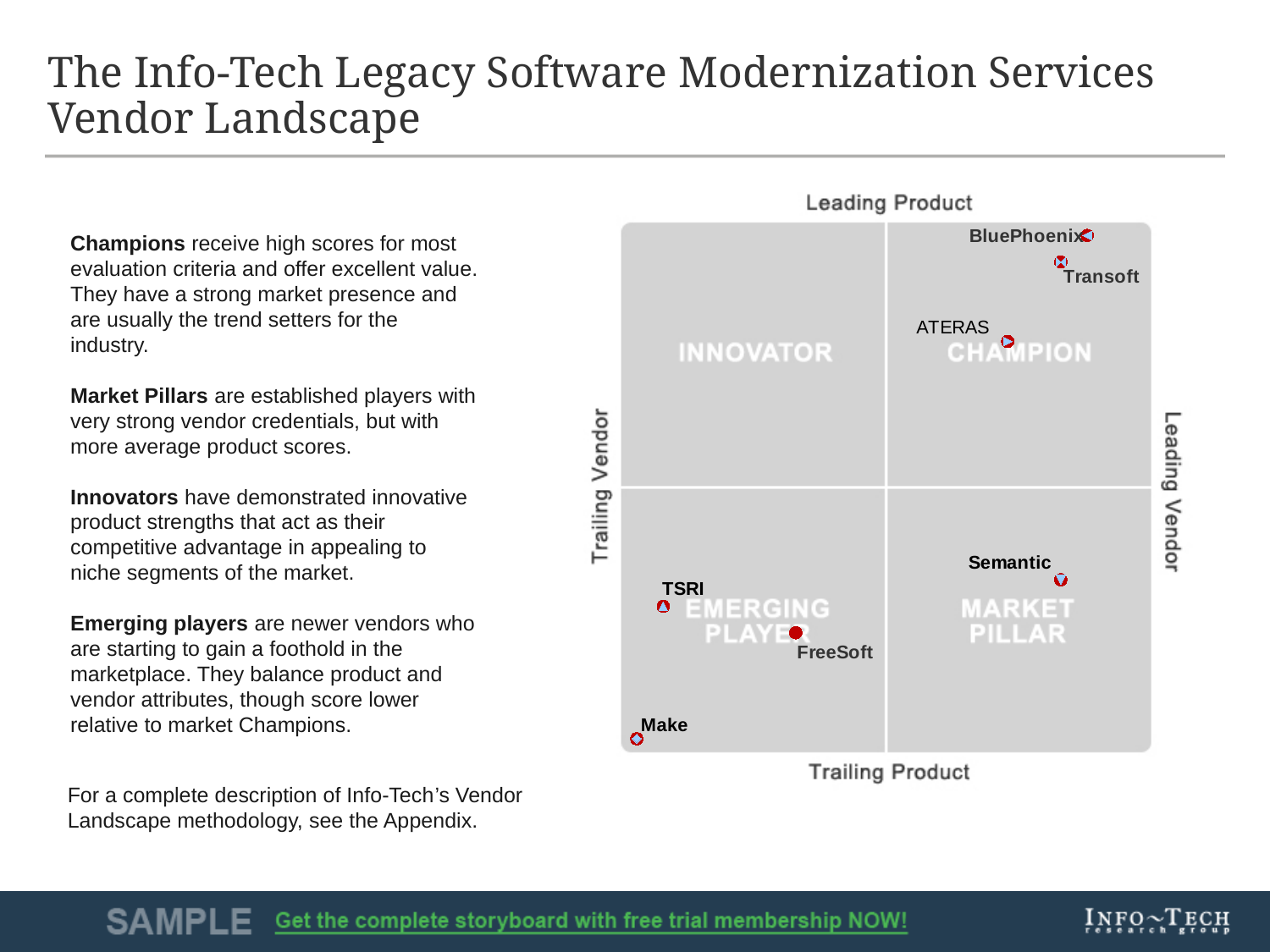
Which vendor is plotted highest on the chart (closest to Leading Product)? BluePhoenix Which quadrant is FreeSoft plotted in? Emerging Player Which quadrant is BluePhoenix plotted in? Champion Which quadrant is Semantic plotted in? Market Pillar How many vendors are plotted on the chart? 7 How many vendors are plotted in the Champion quadrant? 3 Which vendor is plotted further to the right, Semantic or TSRI? Semantic Which vendor is plotted lowest on the chart (closest to Trailing Product)? Make Which vendor is plotted higher on the chart, ATERAS or Transoft? Transoft What kind of chart is shown on the slide? Scatter chart (quadrant chart) Which quadrant contains no vendors? Innovator What label appears at the top of the chart's vertical axis? Leading Product